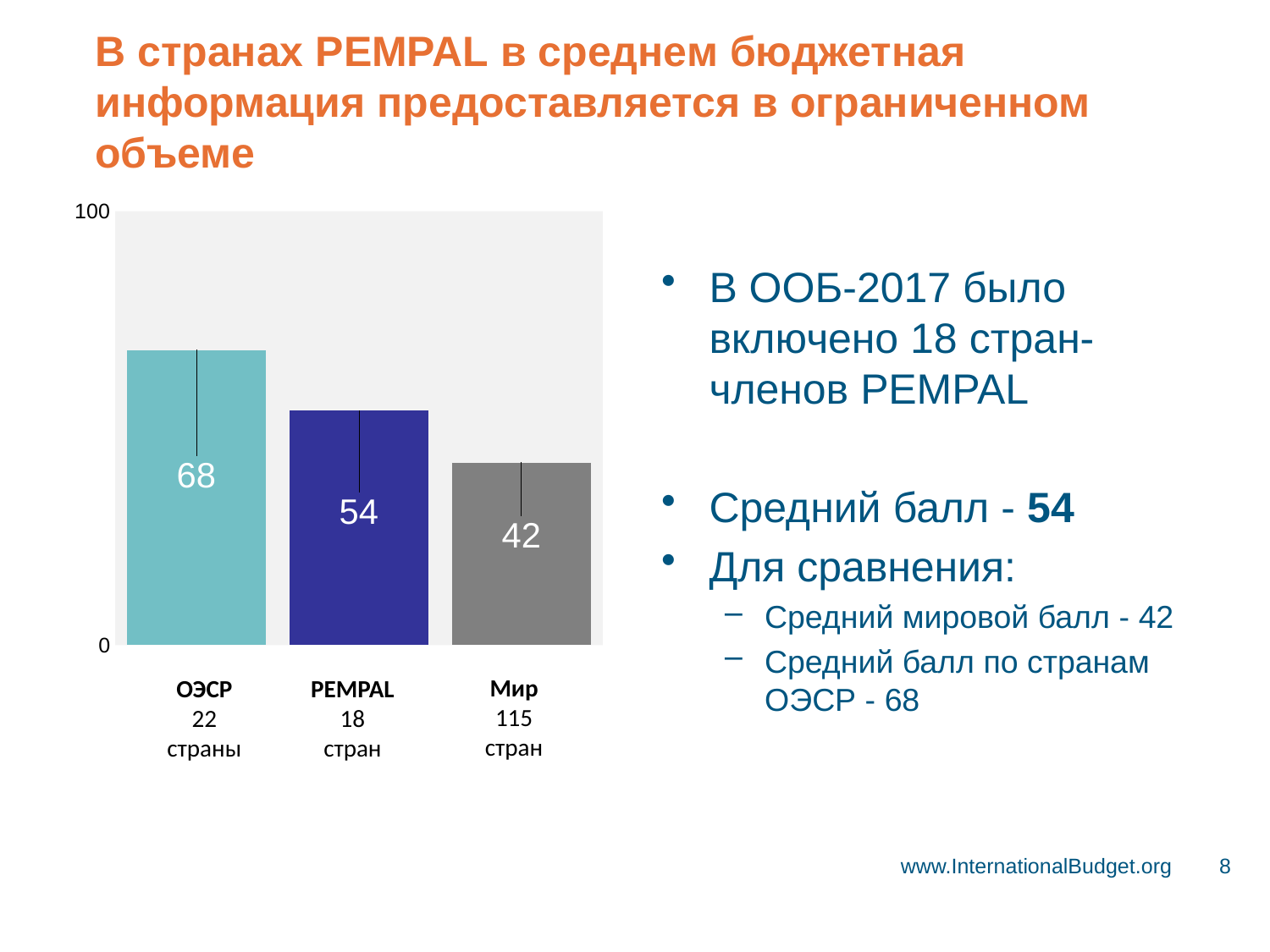
Which is larger, the value for PEMPAL or the value for Мир? PEMPAL Which category has the highest value in the chart? ОЭСР What kind of chart is shown on the slide? Bar chart How many countries are listed under the PEMPAL category label in the chart? 18 What is the difference between the values for ОЭСР and PEMPAL? 14 What is the value shown for Мир in the chart? 42 What is the difference between the values for PEMPAL and Мир? 12 How many categories are shown in the chart? 3 What is the value shown for ОЭСР in the chart? 68 Do the values rise or fall from left to right across the chart? Fall Which category has the lowest value in the chart? Мир What is the value shown for PEMPAL in the chart? 54